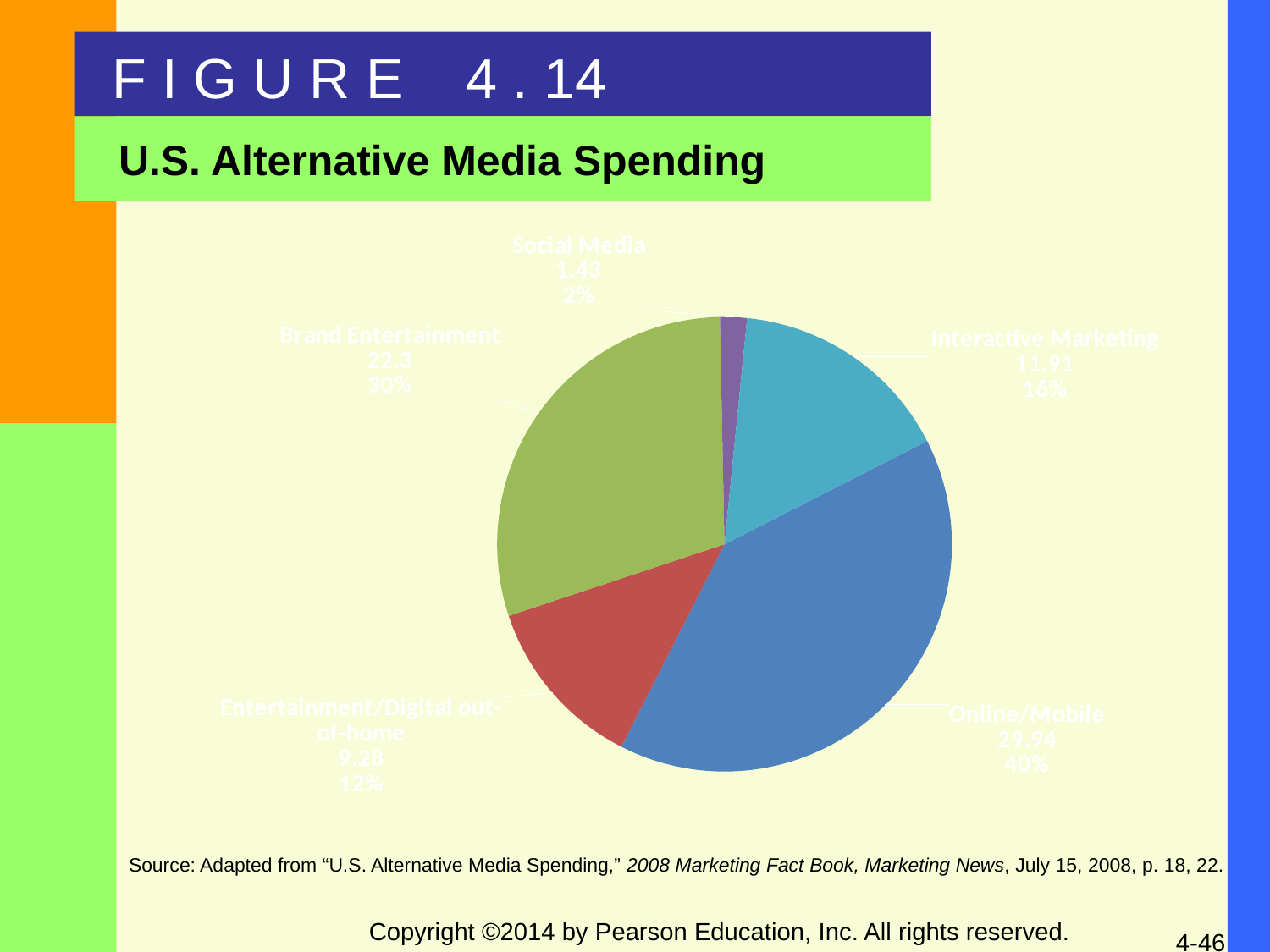
What share of the pie does Entertainment/Digital out-of-home represent? 12% How many slices does the pie chart have? 5 What share of the pie does Online/Mobile represent? 40% Which category has the largest slice of the pie? Online/Mobile Which is larger, Brand Entertainment or Interactive Marketing? Brand Entertainment What is the value shown for Online/Mobile? 29.94 What is the value shown for Social Media? 1.43 What is the value shown for Brand Entertainment? 22.3 What is the value shown for Interactive Marketing? 11.91 What kind of chart is shown on the slide? pie chart What is the difference between the values for Online/Mobile and Brand Entertainment? 7.64 Which category has the smallest slice of the pie? Social Media